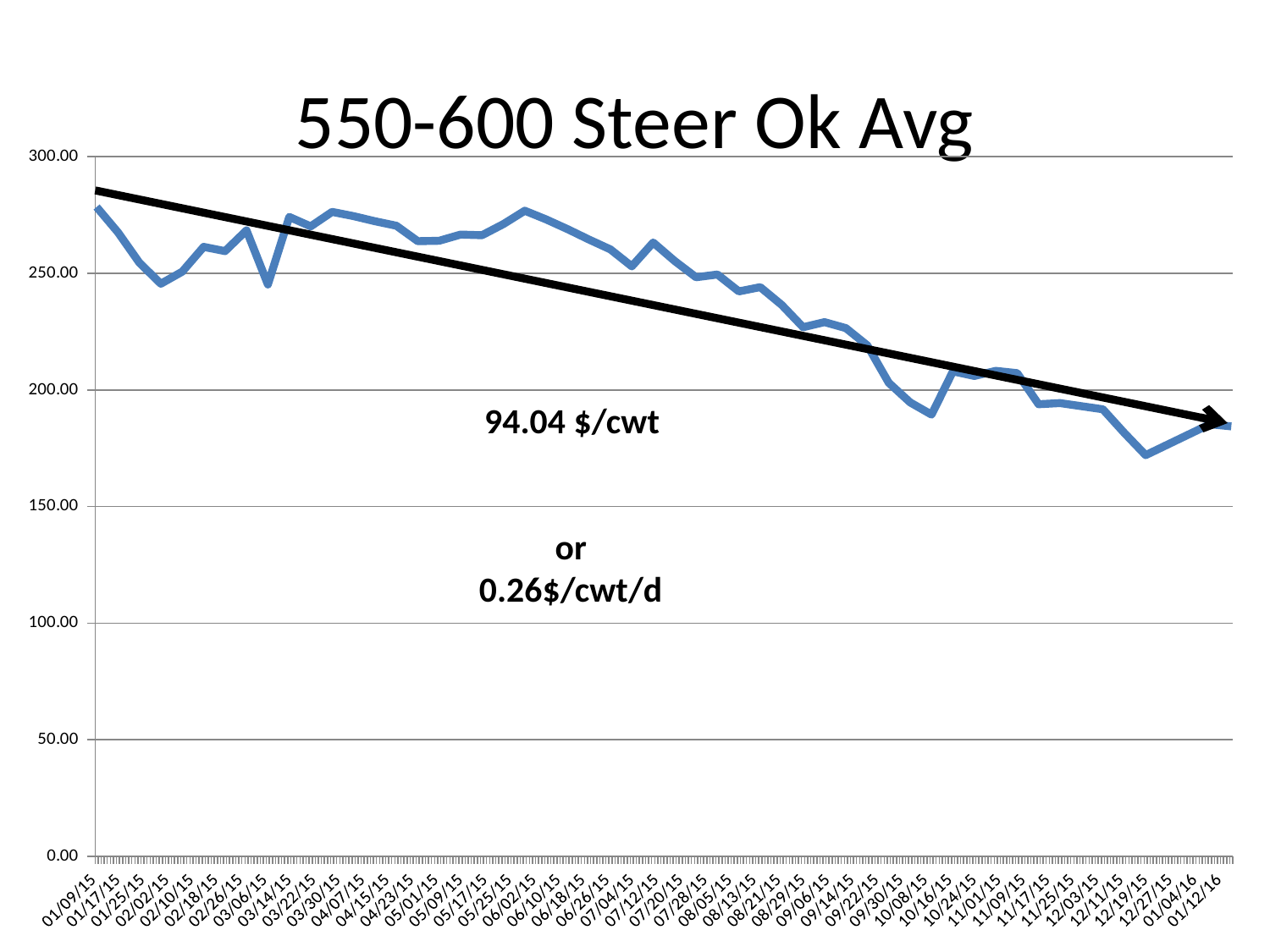
Do the plotted values generally rise or fall from left to right along the x axis? fall Is the value for 01/09/15 greater or less than 250.00? greater What total decline in $/cwt is printed as an annotation on the chart? 94.04 $/cwt Which date has the lowest plotted value? 12/19/15 Is the value for 06/02/15 greater or less than 250.00? greater Is the value for 01/12/16 greater or less than 200.00? less Which is larger, the value for 01/09/15 or the value for 01/12/16? 01/09/15 What kind of chart is shown on the slide? line chart What is the title of the chart? 550-600 Steer Ok Avg